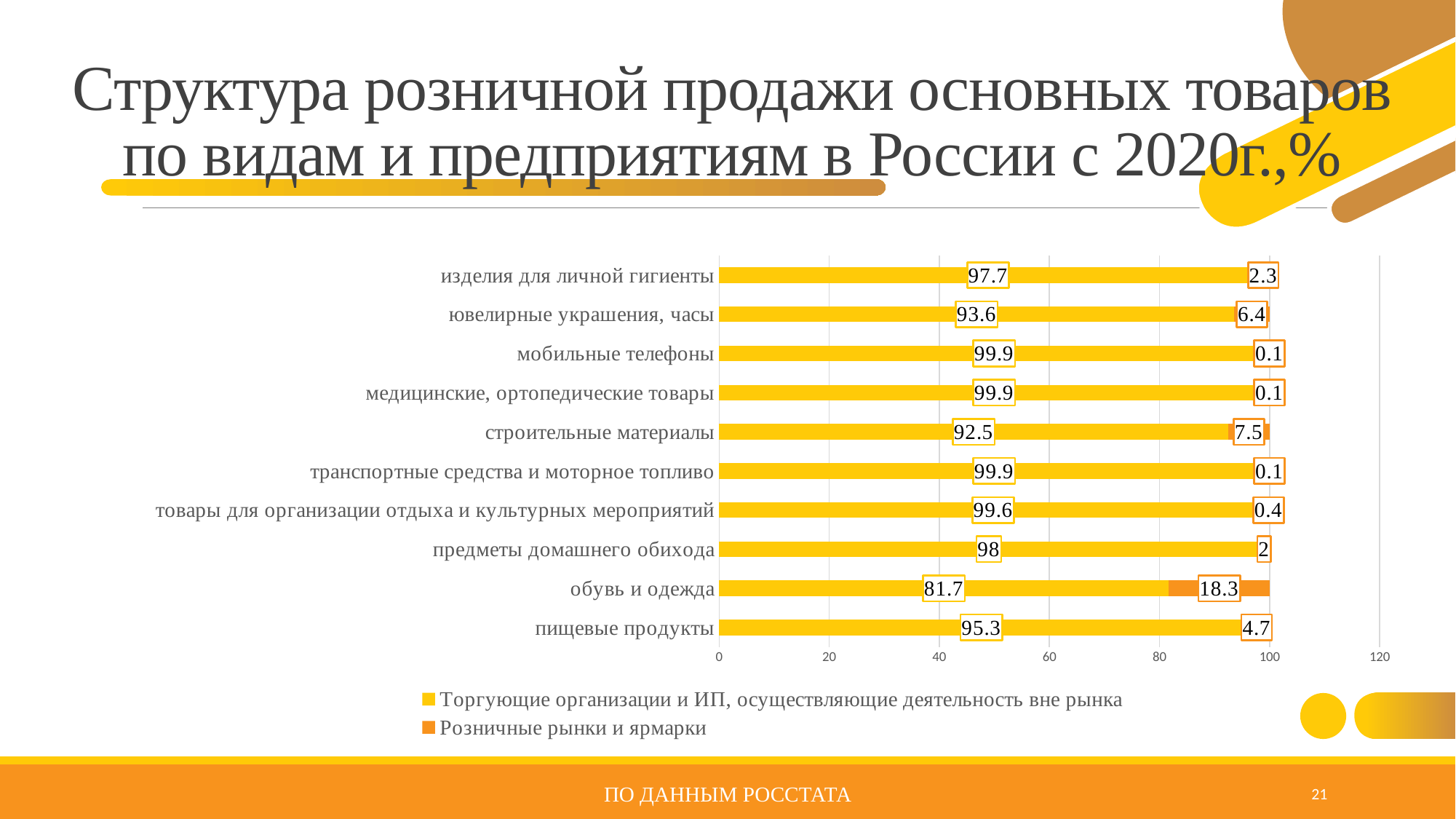
What is the value for 'Розничные рынки и ярмарки' for 'ювелирные украшения, часы'? 6.4 What is the value for 'Торгующие организации и ИП, осуществляющие деятельность вне рынка' for 'обувь и одежда'? 81.7 Which is larger: the 'Розничные рынки и ярмарки' value for 'изделия для личной гигиены' or for 'предметы домашнего обихода'? изделия для личной гигиенты How many series does the legend list? 2 What is the difference between the 'Розничные рынки и ярмарки' values for 'обувь и одежда' and 'пищевые продукты'? 13.6 What is the value for 'Торгующие организации и ИП, осуществляющие деятельность вне рынка' for 'пищевые продукты'? 95.3 How many categories are shown on the chart? 10 Which category has the highest value for 'Розничные рынки и ярмарки'? обувь и одежда Which category has the lowest value for 'Торгующие организации и ИП, осуществляющие деятельность вне рынка'? обувь и одежда What is the value for 'Розничные рынки и ярмарки' for 'строительные материалы'? 7.5 What is the total of the stacked bar for 'обувь и одежда'? 100 What kind of chart is shown on the slide? Stacked bar chart